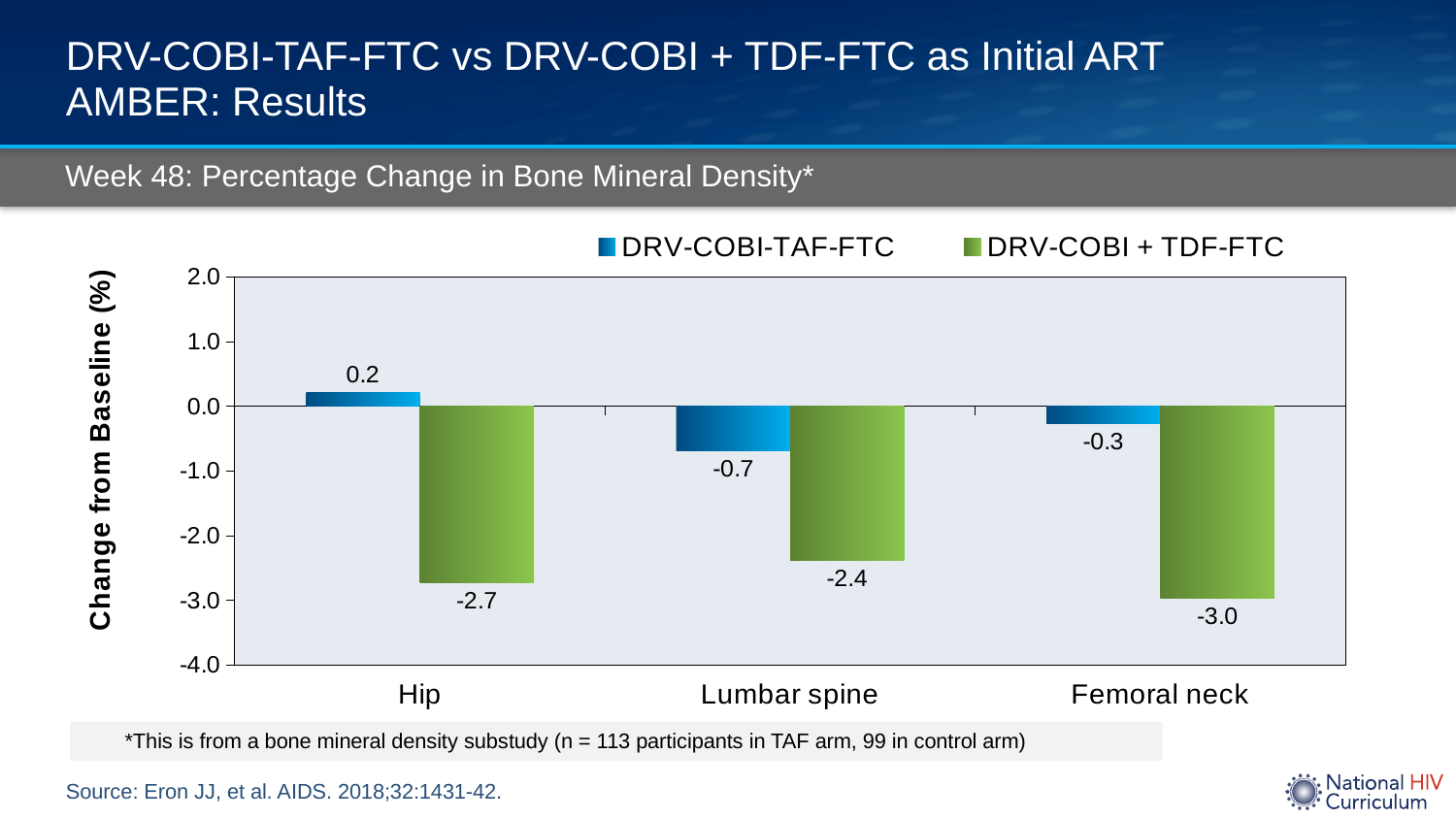
For DRV-COBI-TAF-FTC, which site shows the highest change from baseline? Hip How many bone sites (categories) are shown on the x axis? 3 What is the difference between the DRV-COBI-TAF-FTC and DRV-COBI + TDF-FTC values at the lumbar spine? 1.7 At the femoral neck, which regimen has the larger (less negative) change from baseline? DRV-COBI-TAF-FTC How many series does the legend list? 2 What is the percentage change from baseline at the lumbar spine for DRV-COBI + TDF-FTC? -2.4 What is the percentage change from baseline in bone mineral density at the hip for DRV-COBI-TAF-FTC? 0.2 What is the percentage change from baseline at the hip for DRV-COBI + TDF-FTC? -2.7 For DRV-COBI + TDF-FTC, which site shows the lowest (most negative) change from baseline? Femoral neck What kind of chart is shown on the slide? Bar chart What is the percentage change from baseline at the femoral neck for DRV-COBI-TAF-FTC? -0.3 Is the value for DRV-COBI + TDF-FTC at the hip greater or less than -2.0? less